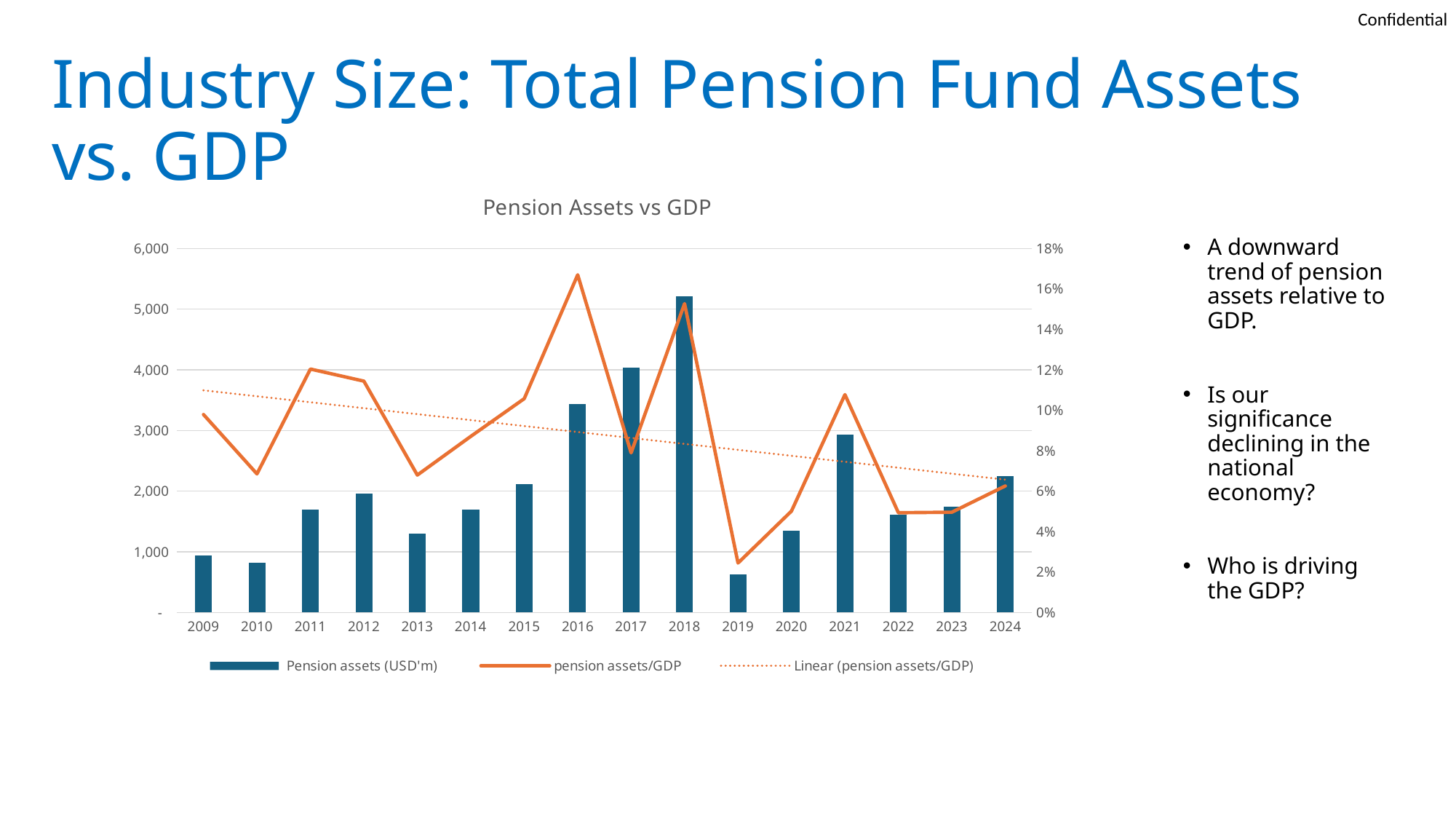
Is the pension assets/GDP value for 2016 greater or less than 16%? greater How many series does the legend list? 3 Which year has a larger Pension assets (USD'm) bar, 2017 or 2021? 2017 Is the pension assets/GDP value for 2019 greater or less than 4%? less In which year does the pension assets/GDP line reach its highest point? 2016 Which year has the lowest Pension assets (USD'm) bar? 2019 Is the Pension assets (USD'm) value for 2018 greater or less than 5,000? greater Which year has the highest Pension assets (USD'm) bar? 2018 In which year does the pension assets/GDP line reach its lowest point? 2019 Does the Linear (pension assets/GDP) trendline rise or fall from 2009 to 2024? fall How many years are shown on the x axis of the chart? 16